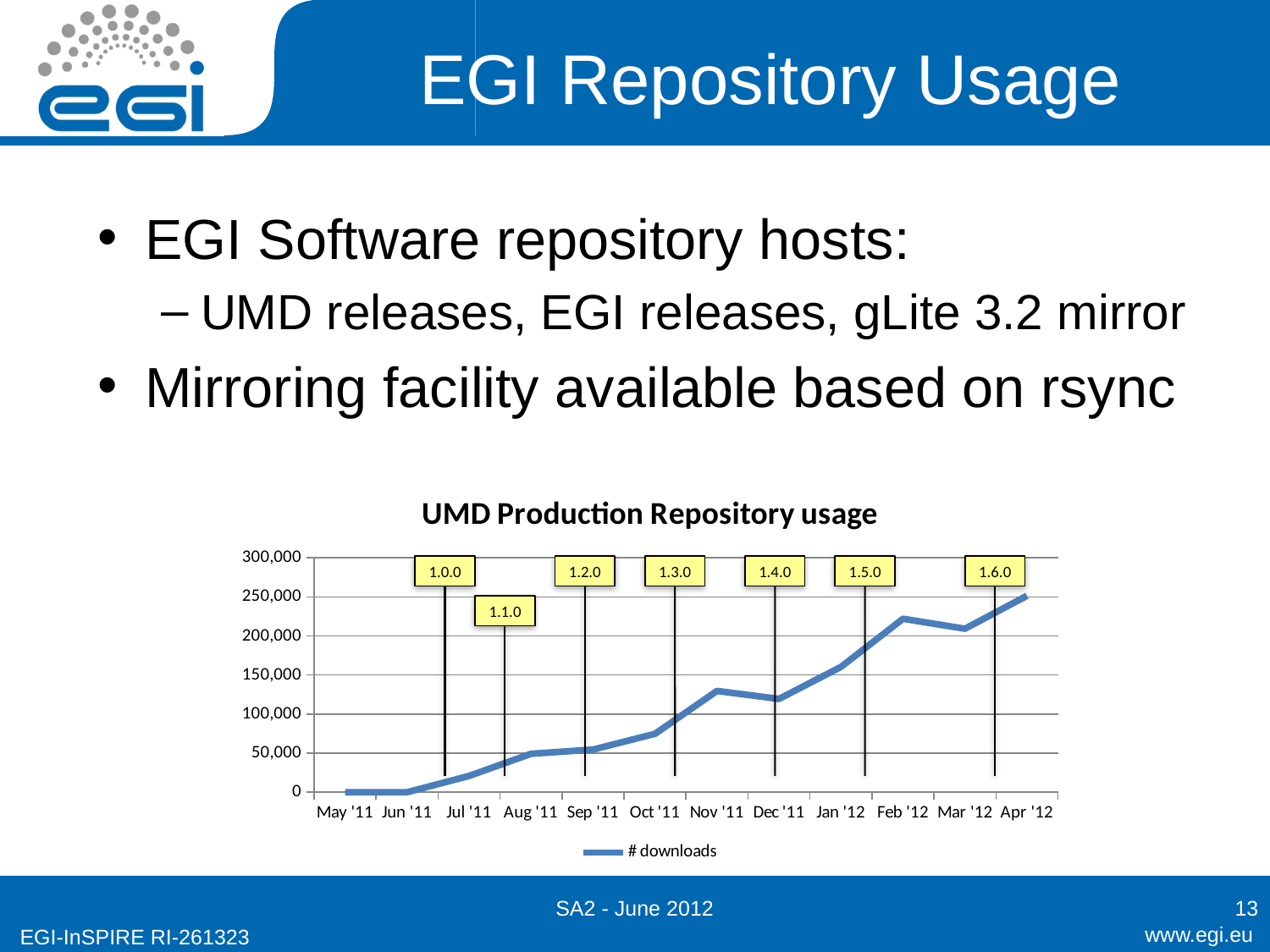
Is the value for Feb '12 greater or less than 200,000? greater Is the value for Jul '11 greater or less than 50,000? less Which month has the highest number of downloads? Apr '12 What kind of chart is shown on the slide? line chart Do the download values generally rise or fall from May '11 to Apr '12? rise Which has more downloads, Dec '11 or Feb '12? Feb '12 Is the value for Oct '11 greater or less than 100,000? less What is the title of the chart? UMD Production Repository usage How many series does the chart legend list? 1 What is the name of the series shown in the legend? # downloads How many months are plotted along the x axis? 12